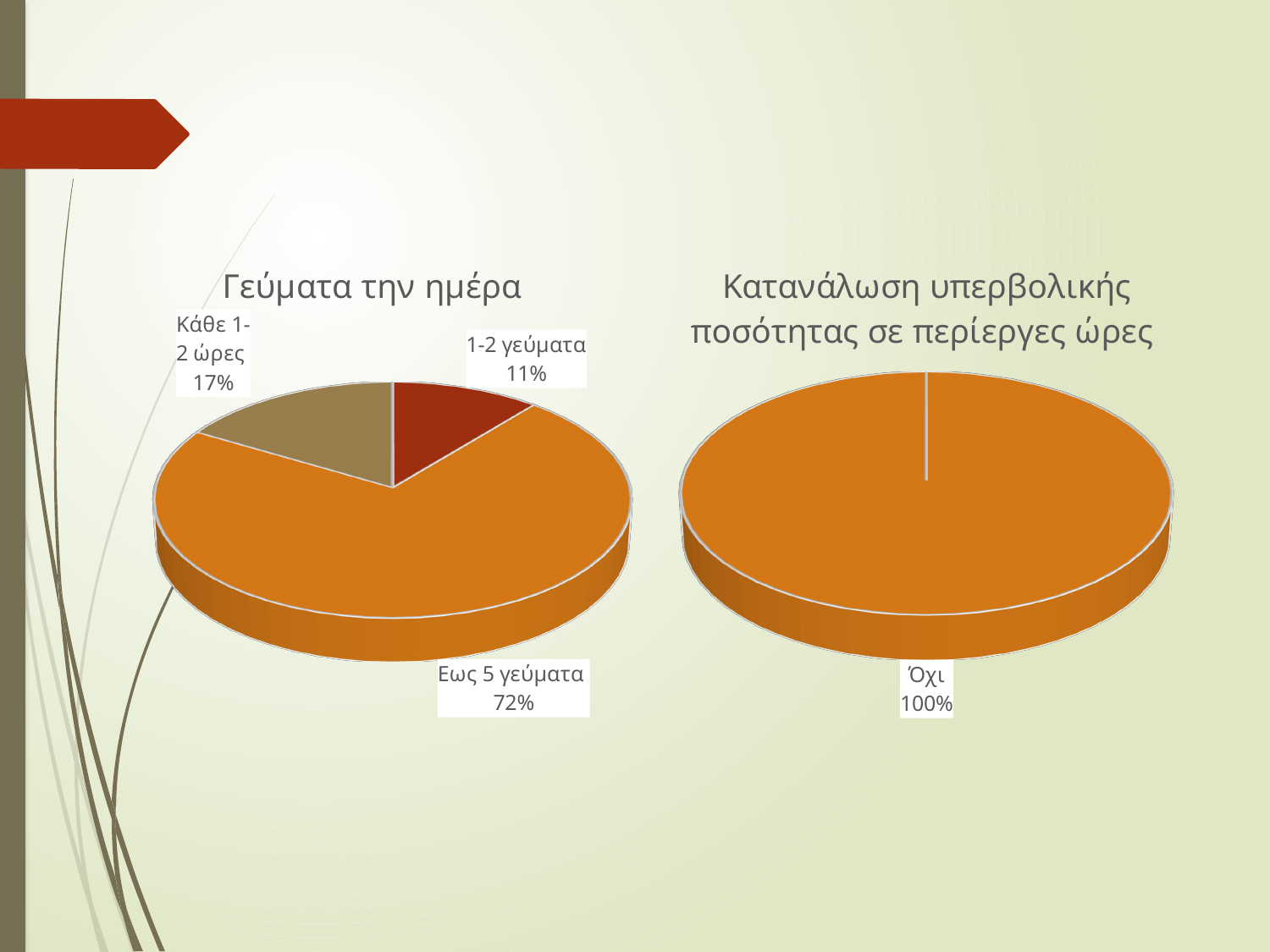
In the 'Γεύματα την ημέρα' chart, which is larger: 'Κάθε 1-2 ώρες' or '1-2 γεύματα'? Κάθε 1-2 ώρες What is the title of the chart on the right side of the slide? Κατανάλωση υπερβολικής ποσότητας σε περίεργες ώρες In the 'Γεύματα την ημέρα' chart, what share does '1-2 γεύματα' have? 11% In the 'Γεύματα την ημέρα' chart, what share does 'Εως 5 γεύματα' have? 72% What kind of chart is the 'Γεύματα την ημέρα' chart? Pie chart In the 'Γεύματα την ημέρα' chart, which category has the smallest slice? 1-2 γεύματα How many categories are shown in the 'Γεύματα την ημέρα' chart? 3 How many categories are shown in the 'Κατανάλωση υπερβολικής ποσότητας σε περίεργες ώρες' chart? 1 In the 'Γεύματα την ημέρα' chart, which category has the largest slice? Εως 5 γεύματα In the 'Γεύματα την ημέρα' chart, what share does 'Κάθε 1-2 ώρες' have? 17% In the 'Γεύματα την ημέρα' chart, what is the difference in percentage points between 'Εως 5 γεύματα' and 'Κάθε 1-2 ώρες'? 55